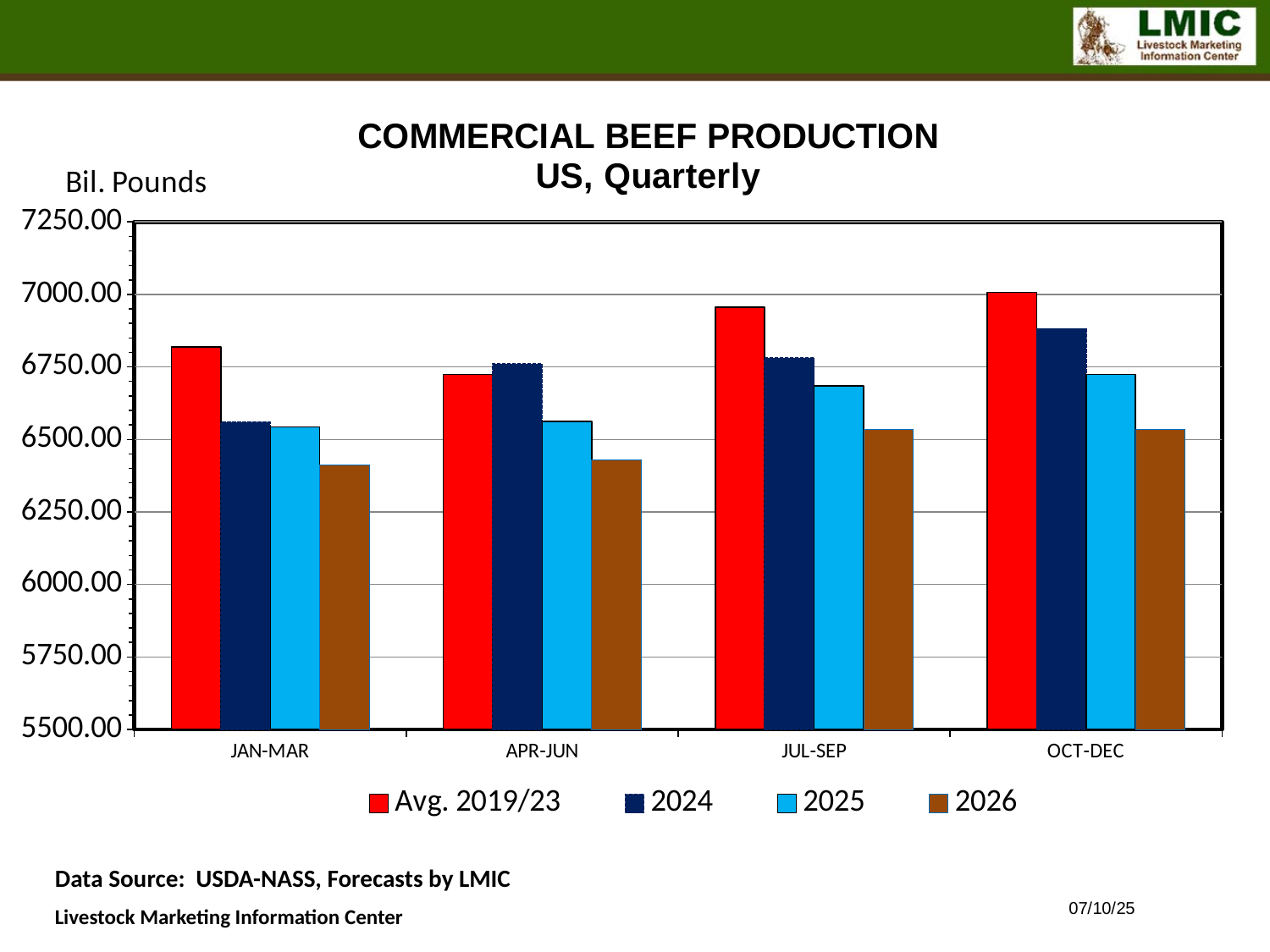
For JAN-MAR, which is larger: the Avg. 2019/23 value or the 2024 value? Avg. 2019/23 What unit label is shown above the y axis? Bil. Pounds How many series does the legend list? 4 In which quarter is the Avg. 2019/23 bar the highest? OCT-DEC Do the 2025 values rise or fall from JAN-MAR to OCT-DEC? rise Is the 2024 value for OCT-DEC greater or less than 7000.00? less Is the 2025 value for JUL-SEP greater or less than 6750.00? less In which quarter is the 2026 bar the lowest? JAN-MAR How many quarters are shown on the x axis? 4 What kind of chart is shown on the slide? bar chart Is the 2026 value for JAN-MAR greater or less than 6500.00? less